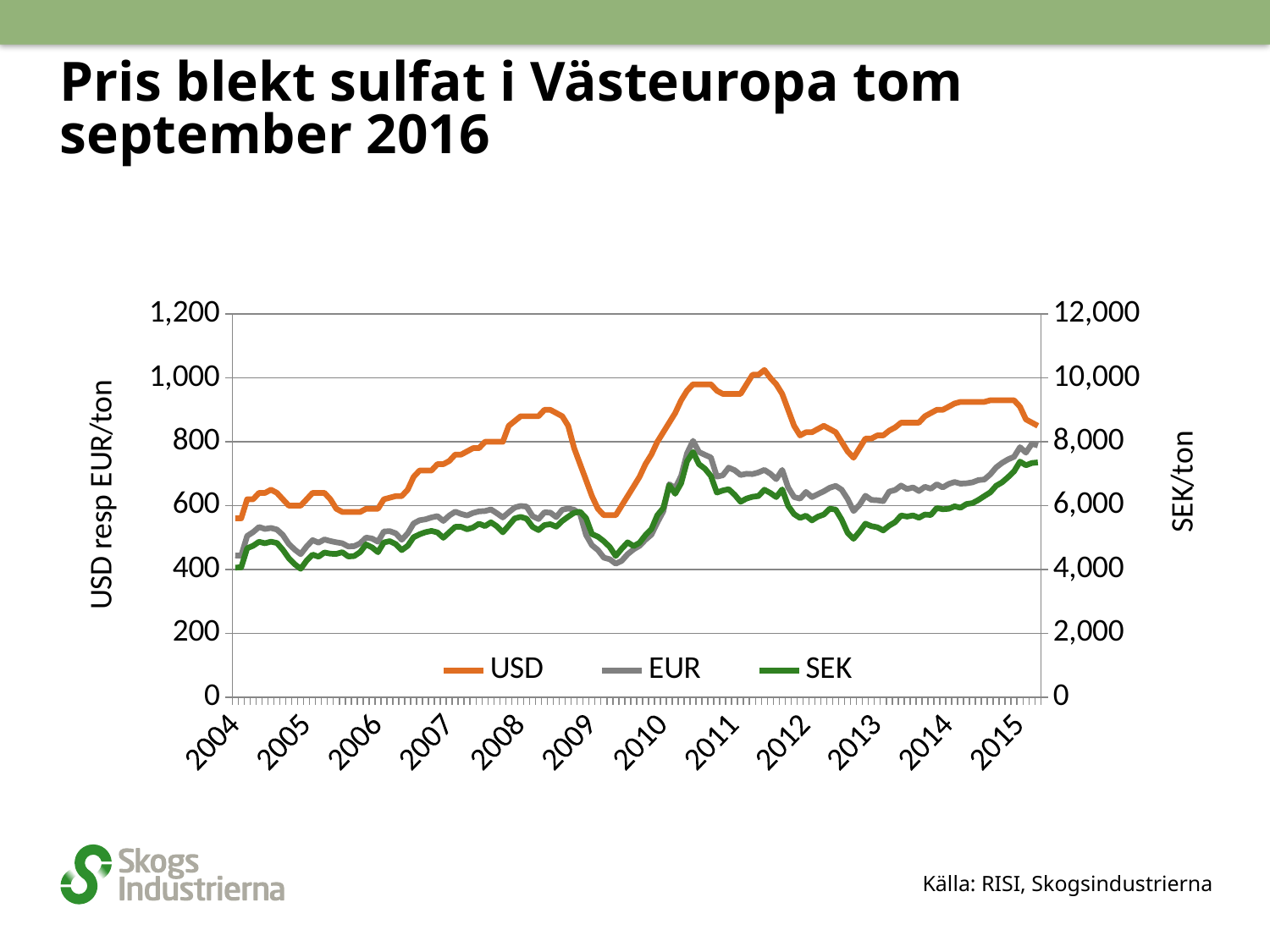
What is the label of the right-hand vertical axis? SEK/ton How many series does the legend list? 3 Is the lowest value of the SEK series in 2009 greater or less than 6,000 on the right-hand axis? less Is the lowest value of the USD series in 2009 greater or less than 600? less How many years are labelled along the x axis? 12 Which series are listed in the legend? USD, EUR, SEK Does the USD series rise or fall from its 2011 peak to 2012? fall Is the peak value of the SEK series in 2010 greater or less than 6,000 on the right-hand axis? greater Which series is higher on the left-hand axis throughout the period, USD or EUR? USD Which series reaches the highest value on the left-hand axis (USD resp EUR/ton)? USD What kind of chart is shown on the slide? line chart